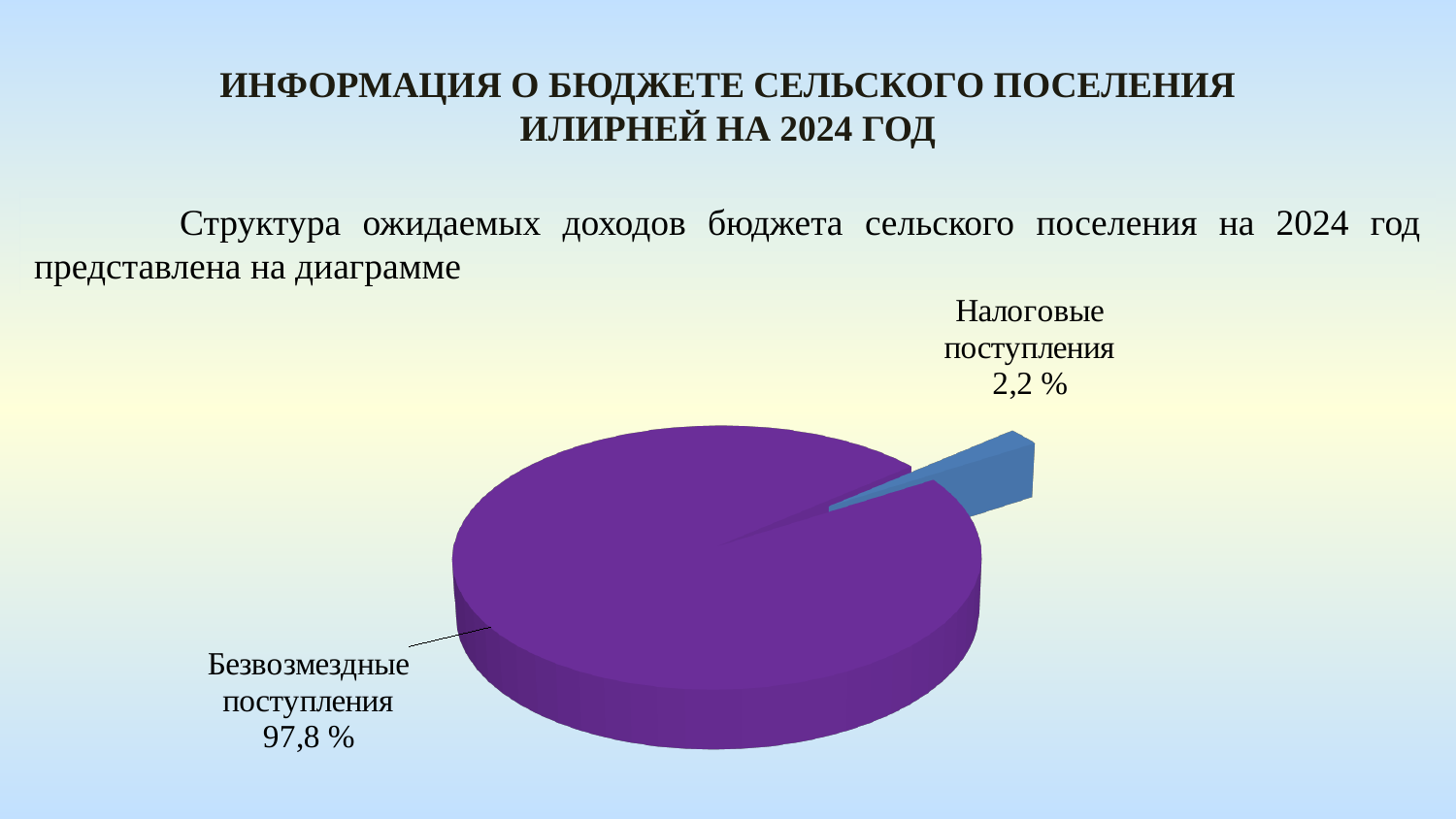
Which slice of the pie is the largest? Безвозмездные поступления What colour is the slice for Безвозмездные поступления? Purple How many slices does the pie chart have? 2 By how many percentage points does Безвозмездные поступления exceed Налоговые поступления? 95,6 What colour is the slice for Налоговые поступления? Blue What share of the pie is labelled "Налоговые поступления"? 2,2 % Which slice of the pie is the smallest? Налоговые поступления Which is larger: Безвозмездные поступления or Налоговые поступления? Безвозмездные поступления What kind of chart is shown on the slide? Pie chart What is the combined share of the two slices in the pie chart? 100 % What share of the pie is labelled "Безвозмездные поступления"? 97,8 %